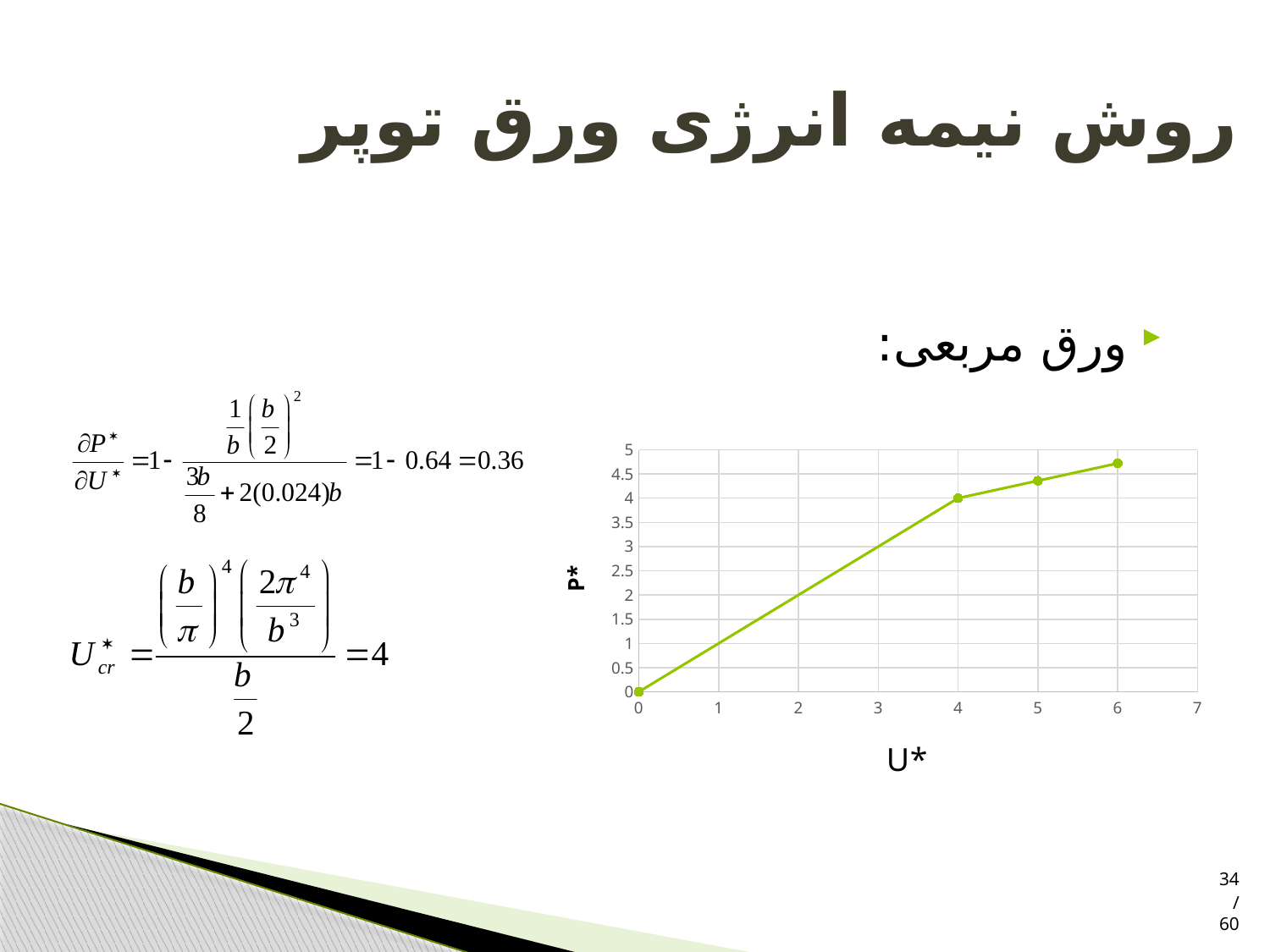
What is the value of P* at U* = 0? 0 Is the value of P* at U* = 6 greater or less than 4.5? greater What kind of chart is shown on the slide? line chart How many data points are plotted on the line chart? 4 What is the value of P* at U* = 4? 4 At which U* value is P* highest? 6 Which has the larger P* value, U* = 4 or U* = 6? U* = 6 Is the value of P* at U* = 5 greater or less than 4? greater Is the value of P* at U* = 5 greater or less than 4.5? less Does P* rise or fall as U* increases along the x axis? rise What is the label of the y axis of the chart? P* What is the label of the x axis of the chart? U*